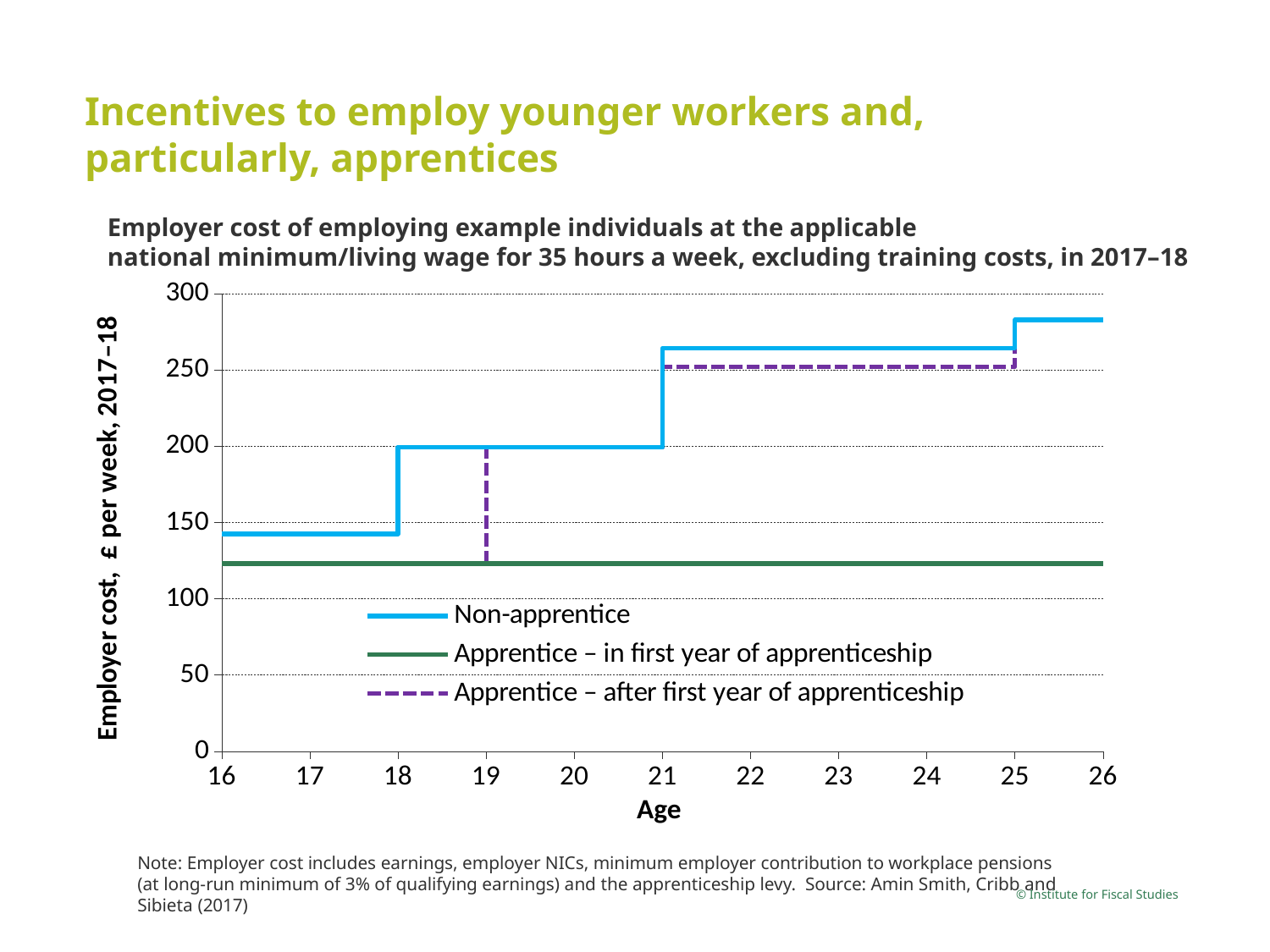
At age 17, which is larger: the employer cost for a non-apprentice or for an apprentice in the first year of apprenticeship? Non-apprentice Does the employer cost for a non-apprentice rise or fall as age increases from 16 to 26? rise Is the employer cost for an apprentice after the first year of apprenticeship at age 23 greater or less than 200? greater What kind of chart is shown on the slide? line chart Is the employer cost for a non-apprentice at age 22 greater or less than 250? greater How many series does the legend list? 3 What is the label on the vertical axis of the chart? Employer cost, £ per week, 2017–18 Which series has the highest employer cost at age 23? Non-apprentice Which series has the lowest employer cost at age 23? Apprentice – in first year of apprenticeship Is the employer cost for a non-apprentice at age 19 greater or less than 150? greater